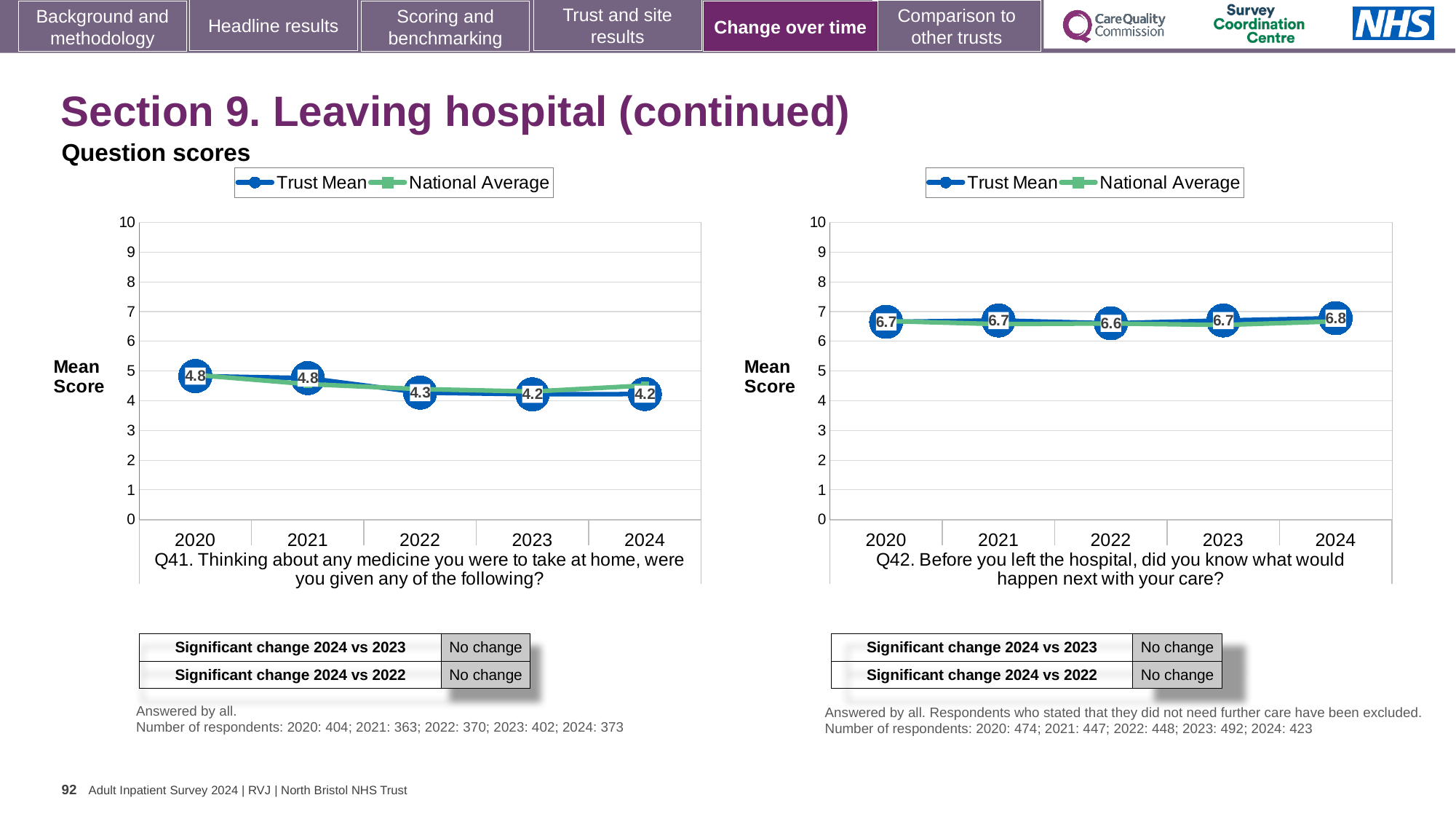
In the Q41 chart on the left, is the National Average value for 2024 greater or less than 4? greater In the Q42 chart on the right, what is the Trust Mean score for 2022? 6.6 How many series does the legend of the Q42 chart on the right list? 2 How many years are plotted on the x axis of the Q41 chart on the left? 5 In the Q41 chart on the left, what is the Trust Mean score for 2024? 4.2 In the Q41 chart on the left, what is the difference between the Trust Mean scores for 2020 and 2024? 0.6 What kind of chart is the Q41 chart on the left? line chart In the Q42 chart on the right, is the Trust Mean score for 2024 larger or smaller than the score for 2022? larger In the Q41 chart on the left, what is the Trust Mean score for 2020? 4.8 In the Q42 chart on the right, is the National Average value for 2020 greater or less than 6? greater In the Q42 chart on the right, which year has the lowest Trust Mean score? 2022 In the Q42 chart on the right, which year has the highest Trust Mean score? 2024